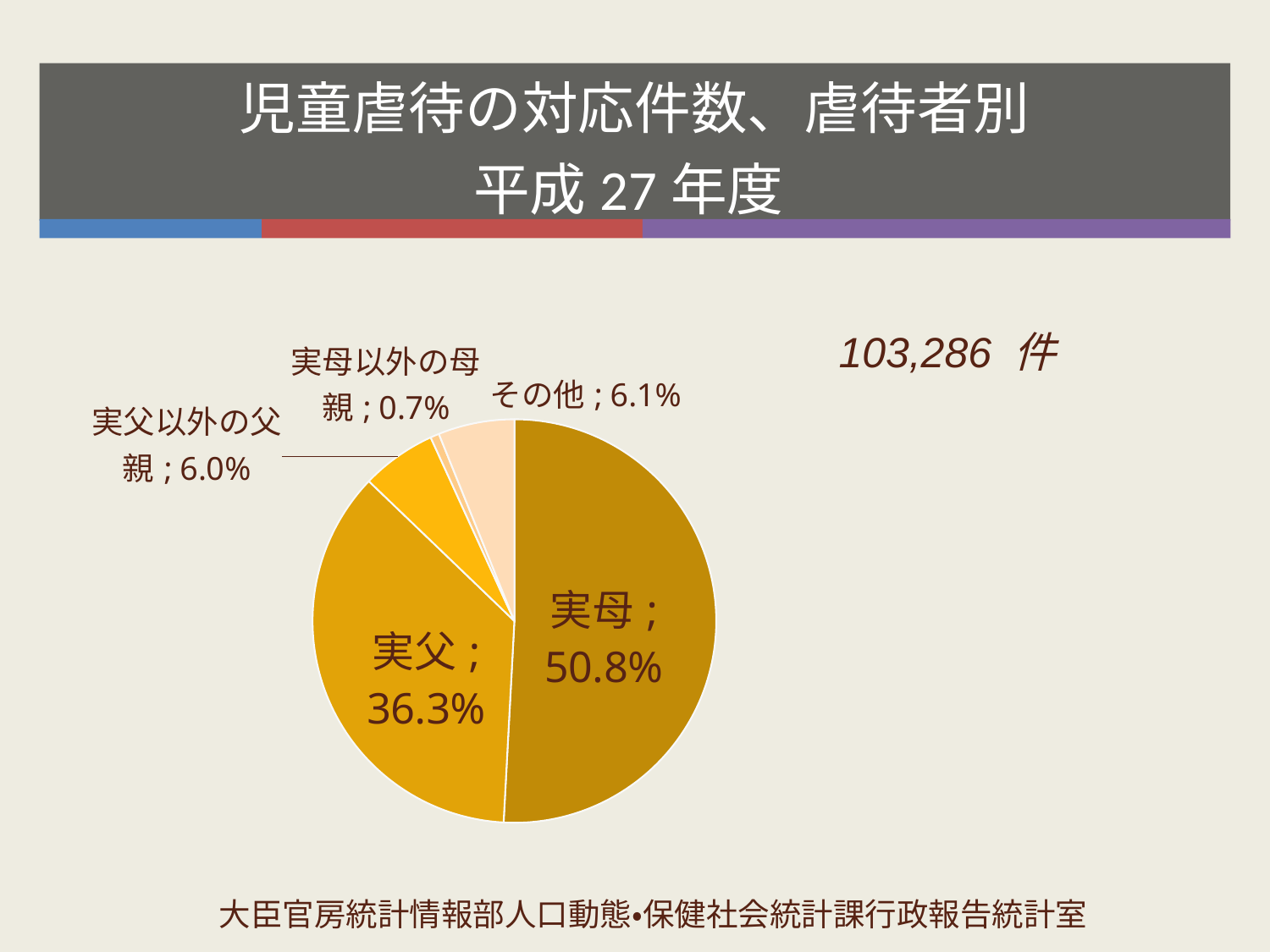
Which category has the smallest slice of the pie? 実母以外の母親 What is the difference in percentage points between the 実母 share and the 実父 share? 14.5 What is the value shown for 実父以外の父親? 6.0% What is the value shown for その他? 6.1% Which category has the largest slice of the pie? 実母 What is the value shown for 実母以外の母親? 0.7% What kind of chart is shown on the slide? pie chart What share of the pie does 実母 account for? 50.8% Which is larger, the share for 実母 or the share for 実父? 実母 What share of the pie does 実父 account for? 36.3% What total number of cases is printed on the slide next to the chart? 103,286 件 How many slices does the pie chart have? 5